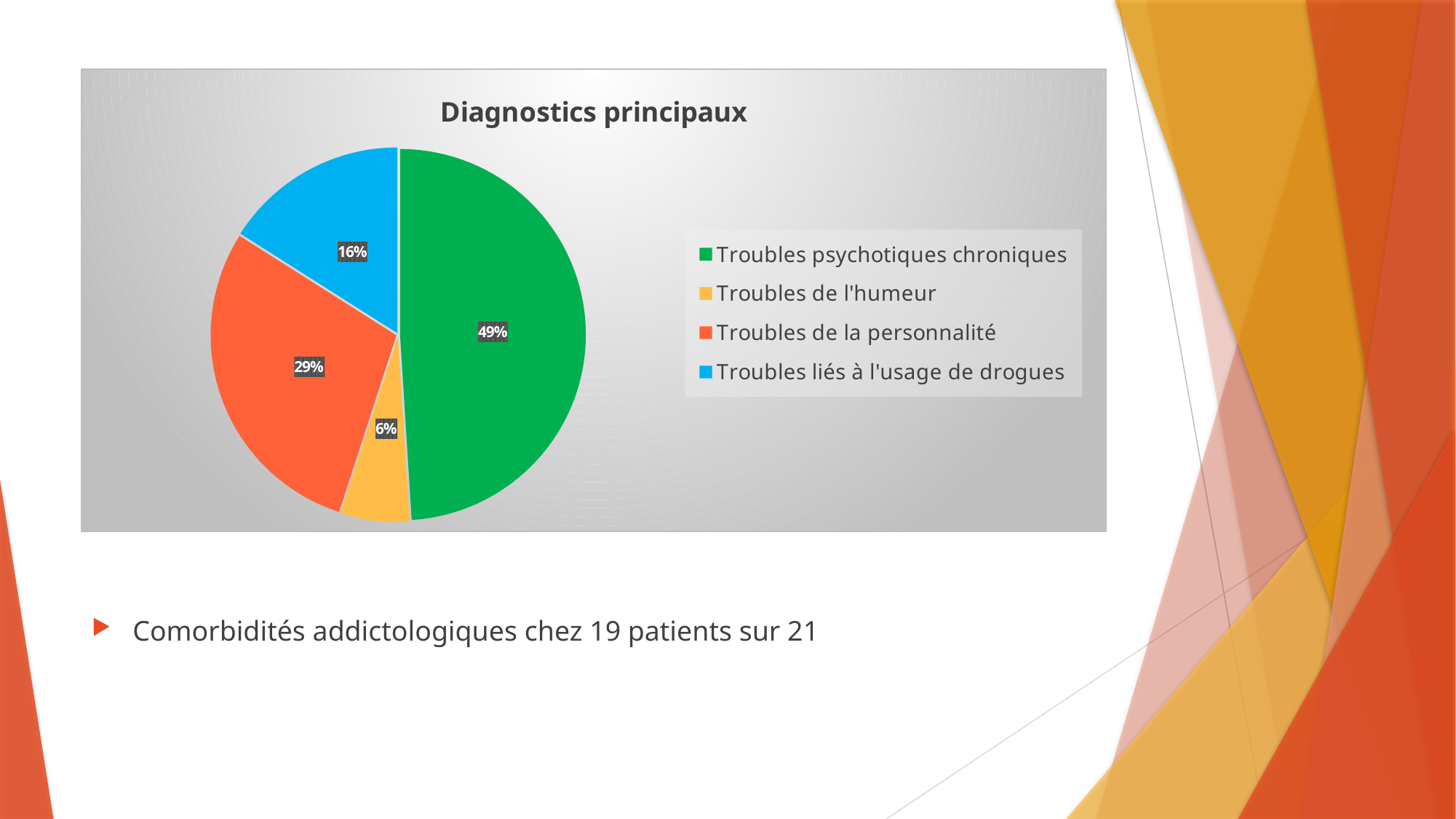
What share of the pie is Troubles de la personnalité? 29% What is the title of the chart? Diagnostics principaux Which is larger: Troubles de la personnalité or Troubles liés à l'usage de drogues? Troubles de la personnalité Which category has the largest slice of the pie? Troubles psychotiques chroniques What colour is the slice for Troubles liés à l'usage de drogues? blue What is the difference in percentage points between Troubles psychotiques chroniques and Troubles de la personnalité? 20 What kind of chart is shown on the slide? pie chart How many categories does the pie chart have? 4 What share of the pie is Troubles psychotiques chroniques? 49% Which category has the smallest slice of the pie? Troubles de l'humeur What share of the pie is Troubles de l'humeur? 6%